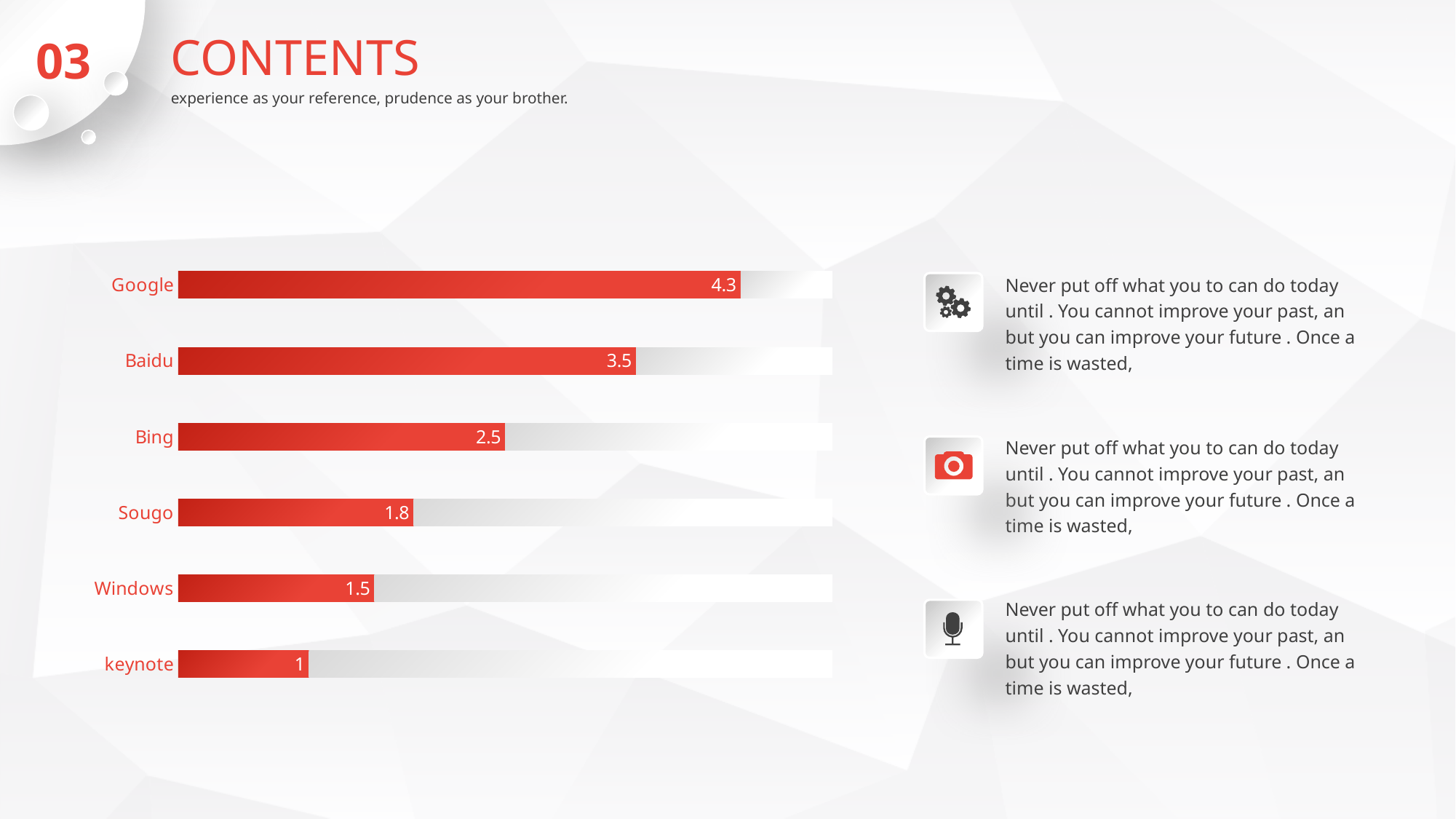
What is the value for Baidu? 3.5 What kind of chart is shown on the slide? Bar chart What is the value for Google? 4.3 Which category has the lowest value? keynote What is the value for Sougo? 1.8 What is the value for keynote? 1 What is the value for Bing? 2.5 Which category has the highest value? Google What is the difference between the values for Sougo and Windows? 0.3 What is the difference between the values for Google and Baidu? 0.8 How many categories are shown in the chart? 6 Which is larger, the value for Bing or the value for Windows? Bing